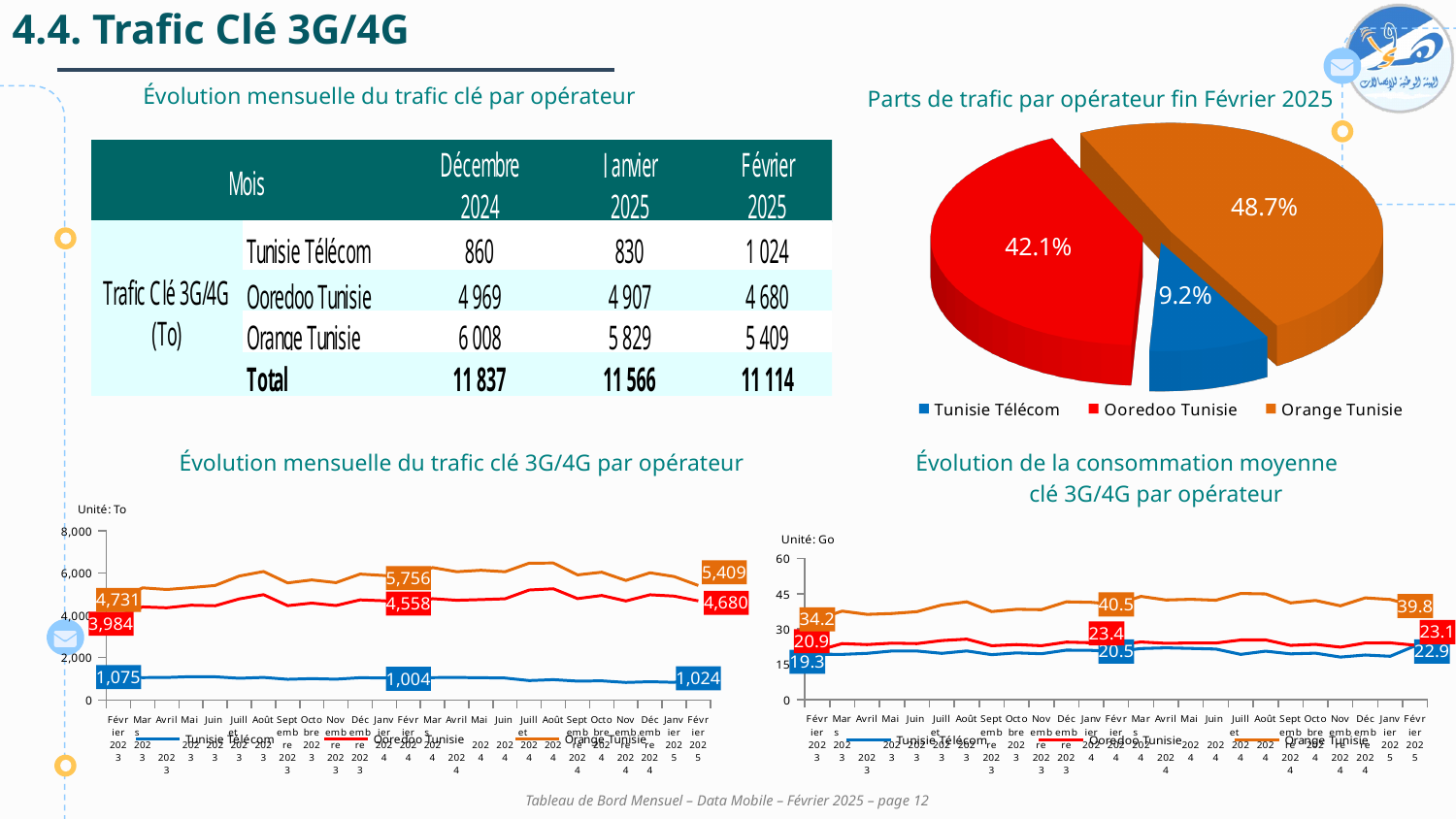
In the chart 'Évolution de la consommation moyenne clé 3G/4G par opérateur', what is the value labelled for Orange Tunisie in Février 2025? 39.8 In the chart 'Évolution de la consommation moyenne clé 3G/4G par opérateur', is the Ooredoo Tunisie value in Février 2025 larger or smaller than the Tunisie Télécom value? Larger In the pie chart 'Parts de trafic par opérateur fin Février 2025', what share does Tunisie Télécom hold? 9.2% In the pie chart 'Parts de trafic par opérateur fin Février 2025', what is the difference between the Orange Tunisie and Ooredoo Tunisie shares? 6.6% In the chart 'Évolution mensuelle du trafic clé 3G/4G par opérateur', what is the value labelled for Tunisie Télécom in Février 2024? 1,004 In the pie chart 'Parts de trafic par opérateur fin Février 2025', what share does Orange Tunisie hold? 48.7% In the chart 'Évolution mensuelle du trafic clé 3G/4G par opérateur', which operator has the highest traffic in Février 2025? Orange Tunisie What type of chart is 'Évolution mensuelle du trafic clé 3G/4G par opérateur'? Line chart In the chart 'Évolution mensuelle du trafic clé 3G/4G par opérateur', what is the value labelled for Orange Tunisie in Février 2025? 5,409 In the pie chart 'Parts de trafic par opérateur fin Février 2025', which operator has the smallest share? Tunisie Télécom In the pie chart 'Parts de trafic par opérateur fin Février 2025', how many operators are listed in the legend? 3 In the chart 'Évolution de la consommation moyenne clé 3G/4G par opérateur', what unit is shown on the axis? Go